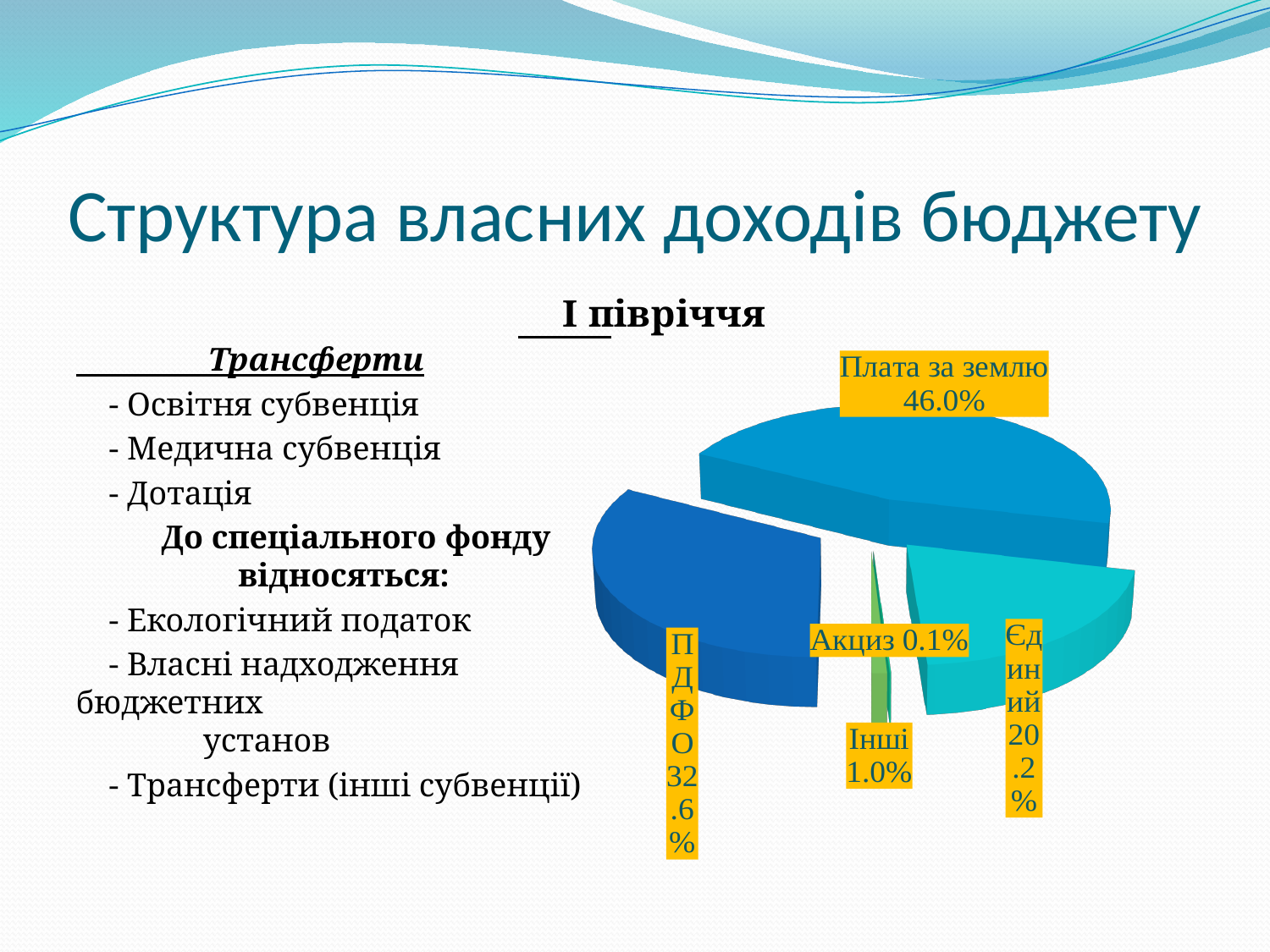
Which slice of the pie is the smallest? Акциз What share of the pie does "Інші" have? 1.0% How many slices does the pie chart have? 5 What is the title of the pie chart? І півріччя What kind of chart is shown on the slide? pie chart What share of the pie does "Плата за землю" have? 46.0% What share of the pie does "ПДФО" have? 32.6% Which is larger, the share for "ПДФО" or the share for "Єдиний"? ПДФО What share of the pie does "Єдиний" have? 20.2% What is the difference in percentage points between "Плата за землю" and "ПДФО"? 13.4 Which slice of the pie is the largest? Плата за землю What share of the pie does "Акциз" have? 0.1%